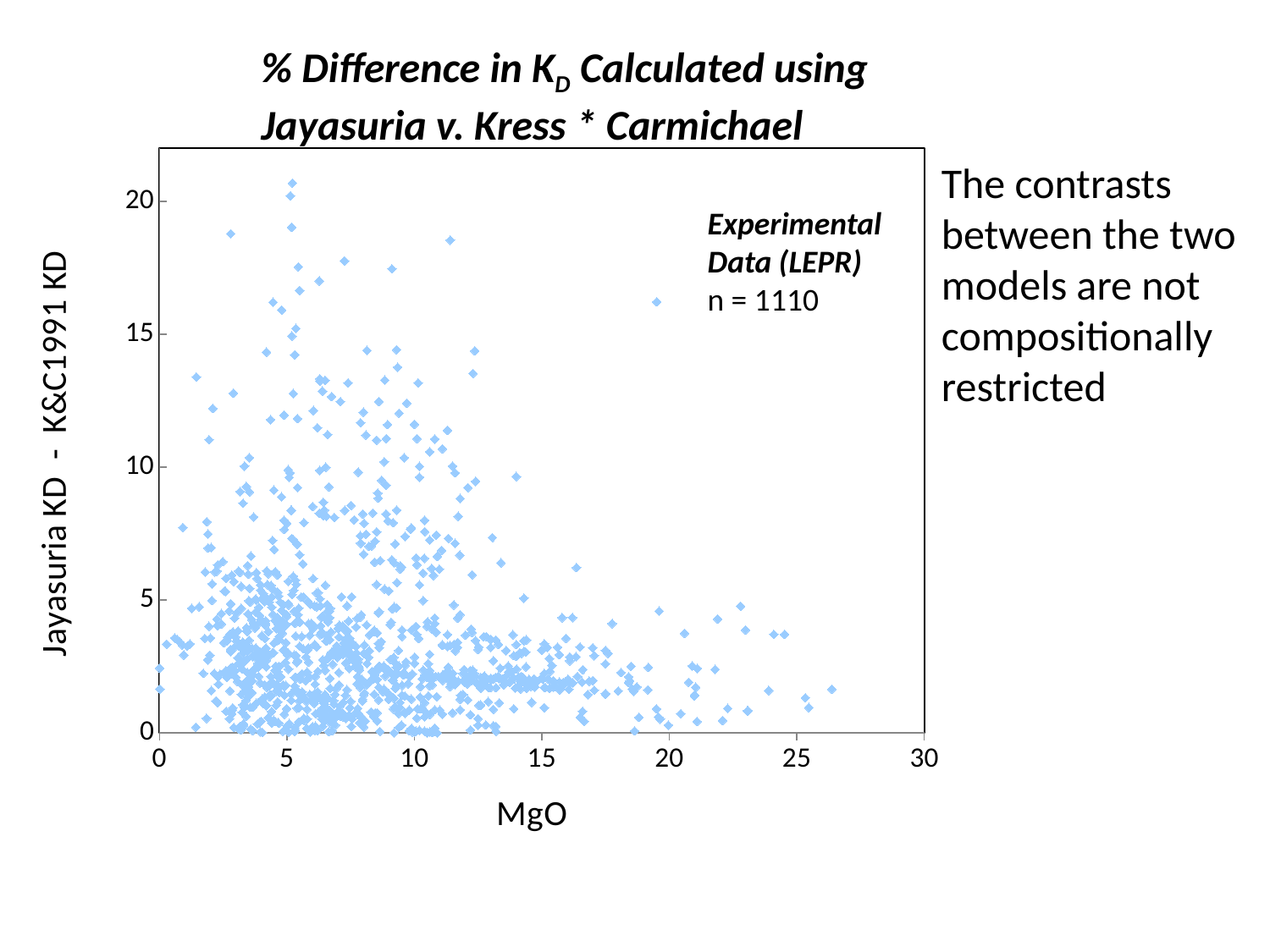
According to the legend, how many data points (n) are plotted? 1110 Is the largest MgO value among the plotted points greater or less than 30? less How many series does the legend list? 1 What is the label of the x axis? MgO Is the highest plotted value on the y axis greater or less than 15? greater What kind of chart is shown on the slide? scatter plot Are the points with MgO greater than 20 plotted at y values greater or less than 10? less What is the name of the series shown in the legend? Experimental Data (LEPR)